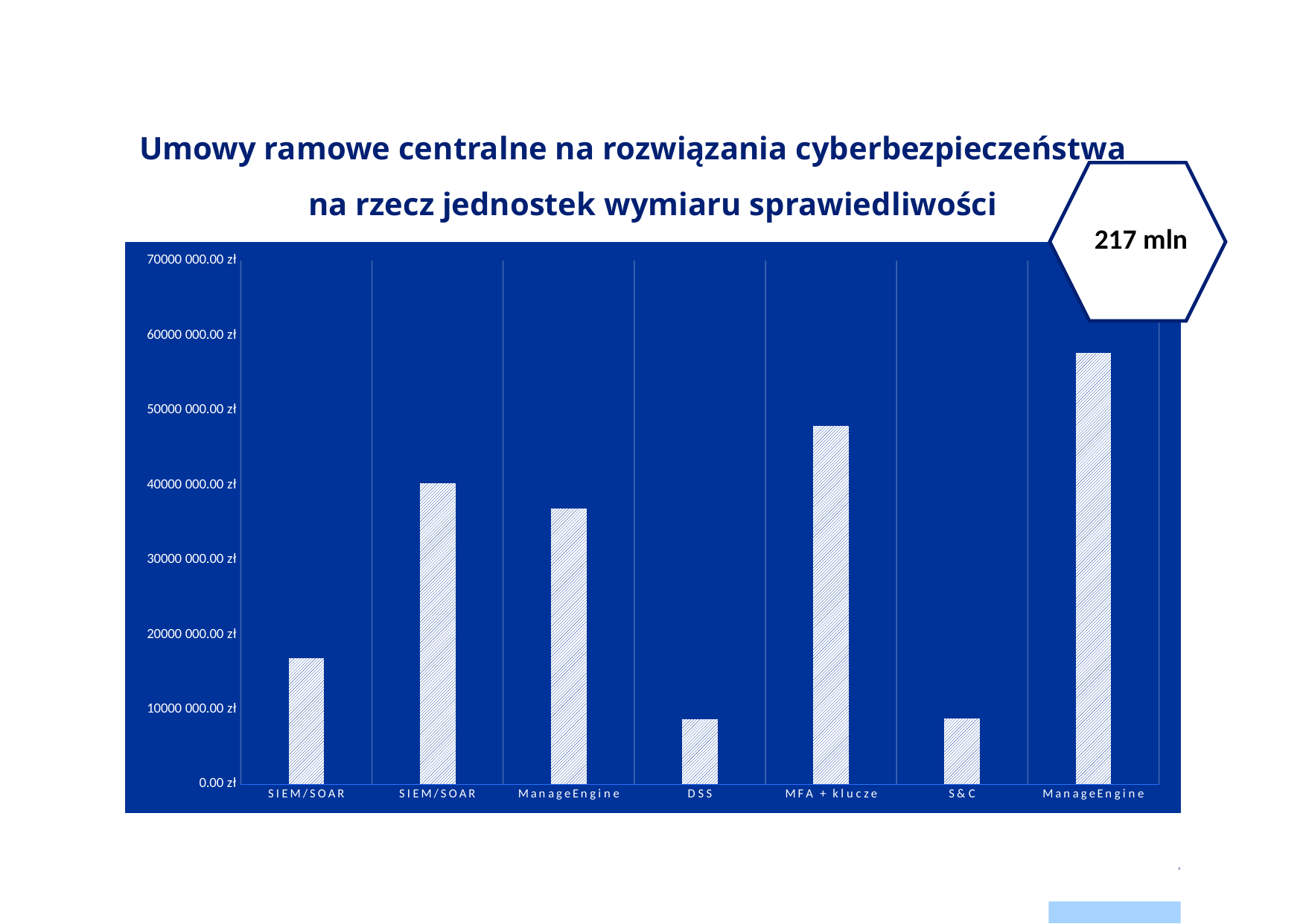
Which is larger, the value for MFA + klucze or the value for the second SIEM/SOAR bar? MFA + klucze Is the value for the rightmost ManageEngine bar greater or less than 50000 000.00 zł? greater Is the value for the first (leftmost) SIEM/SOAR bar greater or less than 20000 000.00 zł? less What kind of chart is shown on the slide? bar chart Is the value for S&C greater or less than 10000 000.00 zł? less Which is larger, the value for the first (leftmost) SIEM/SOAR bar or the value for DSS? SIEM/SOAR (leftmost bar) Which bar is the highest in the chart? ManageEngine (rightmost bar) How many bars are plotted in the chart? 7 What figure is shown in the hexagon callout next to the chart? 217 mln What is the highest value shown on the vertical axis of the chart? 70000 000.00 zł